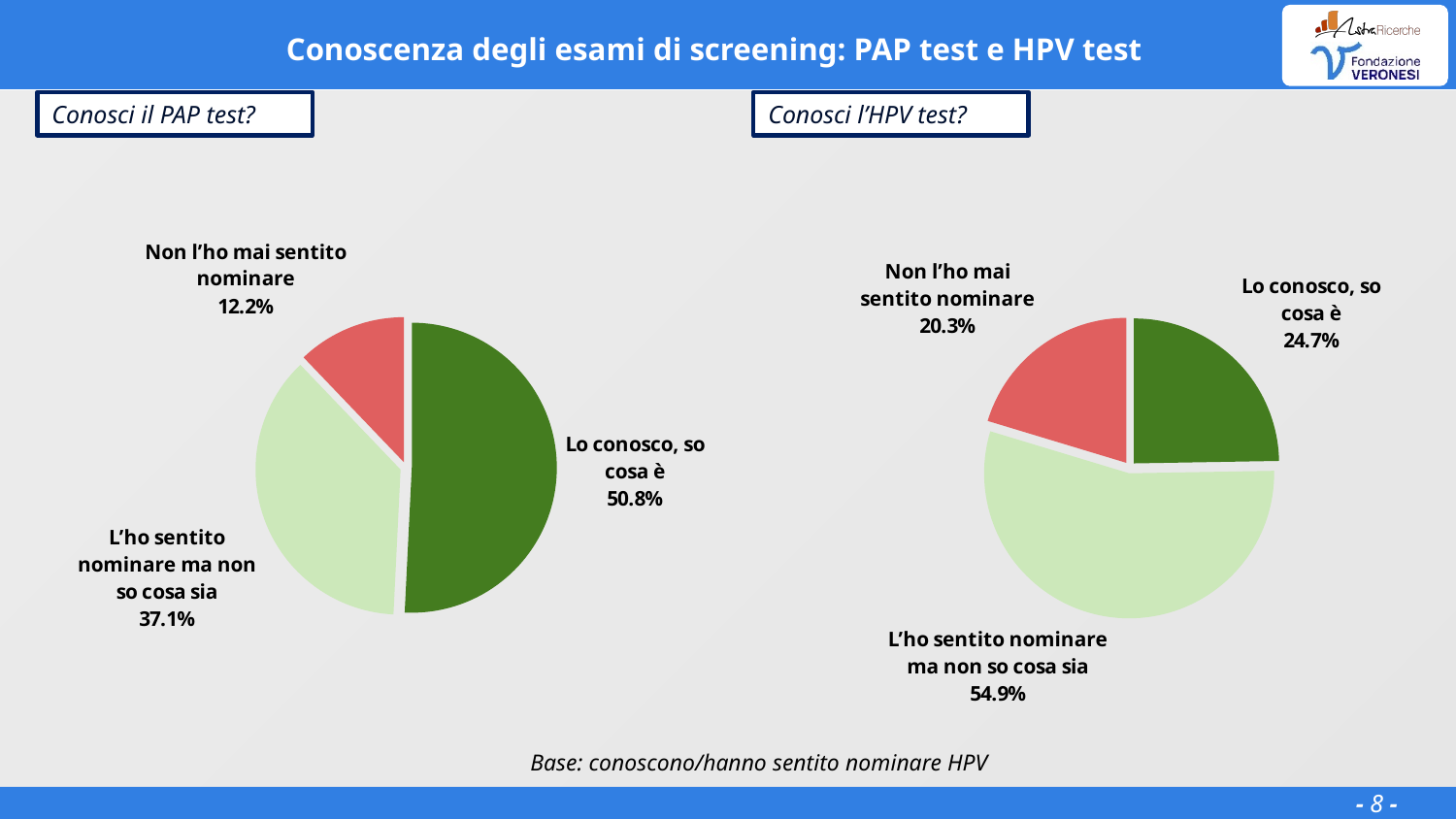
In the 'Conosci il PAP test?' pie chart, what share of respondents answered 'Lo conosco, so cosa è'? 50.8% In the 'Conosci l'HPV test?' pie chart, which response has the smallest slice? Non l'ho mai sentito nominare What is the difference between the 'Lo conosco, so cosa è' share in the PAP test chart and the 'Lo conosco, so cosa è' share in the HPV test chart? 26.1 percentage points In the 'Conosci l'HPV test?' pie chart, what share of respondents answered 'Lo conosco, so cosa è'? 24.7% How many slices does the 'Conosci il PAP test?' pie chart have? 3 In the 'Conosci il PAP test?' pie chart, which response has the largest slice? Lo conosco, so cosa è What colour is the 'Non l'ho mai sentito nominare' slice in both pie charts? Red Which is larger: the 'Non l'ho mai sentito nominare' share in the PAP test chart or in the HPV test chart? HPV test chart What type of chart is used on this slide? Pie chart In the 'Conosci l'HPV test?' pie chart, what share of respondents answered 'L'ho sentito nominare ma non so cosa sia'? 54.9% In the 'Conosci l'HPV test?' pie chart, which response has the largest slice? L'ho sentito nominare ma non so cosa sia In the 'Conosci il PAP test?' pie chart, what share of respondents answered 'Non l'ho mai sentito nominare'? 12.2%